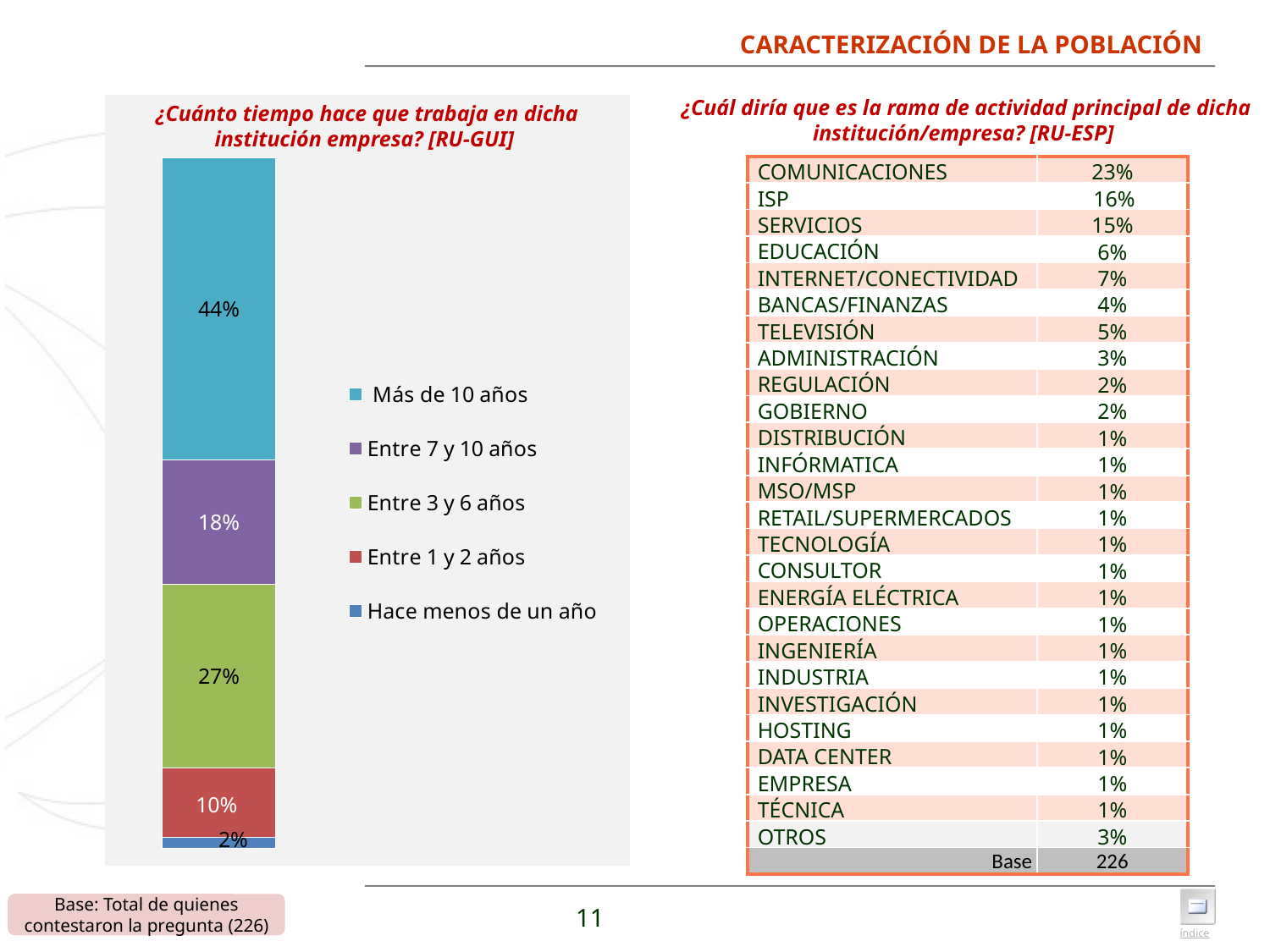
What type of chart is used to show how long respondents have worked at their institution? Stacked bar chart What colour represents 'Entre 3 y 6 años' in the chart? Green Which is larger: the share for 'Entre 7 y 10 años' or for 'Entre 3 y 6 años'? Entre 3 y 6 años What is the difference between the shares for 'Más de 10 años' and 'Entre 3 y 6 años'? 17 percentage points How many categories does the legend of the chart list? 5 Which category has the largest share in the stacked bar? Más de 10 años What percentage is shown for 'Entre 1 y 2 años'? 10% Which category has the smallest share in the stacked bar? Hace menos de un año What value is shown for 'Entre 3 y 6 años'? 27% What percentage corresponds to 'Entre 7 y 10 años' in the stacked bar? 18% What percentage of respondents have worked at their institution for 'Más de 10 años'? 44% What percentage of respondents have worked at their institution for 'Hace menos de un año'? 2%